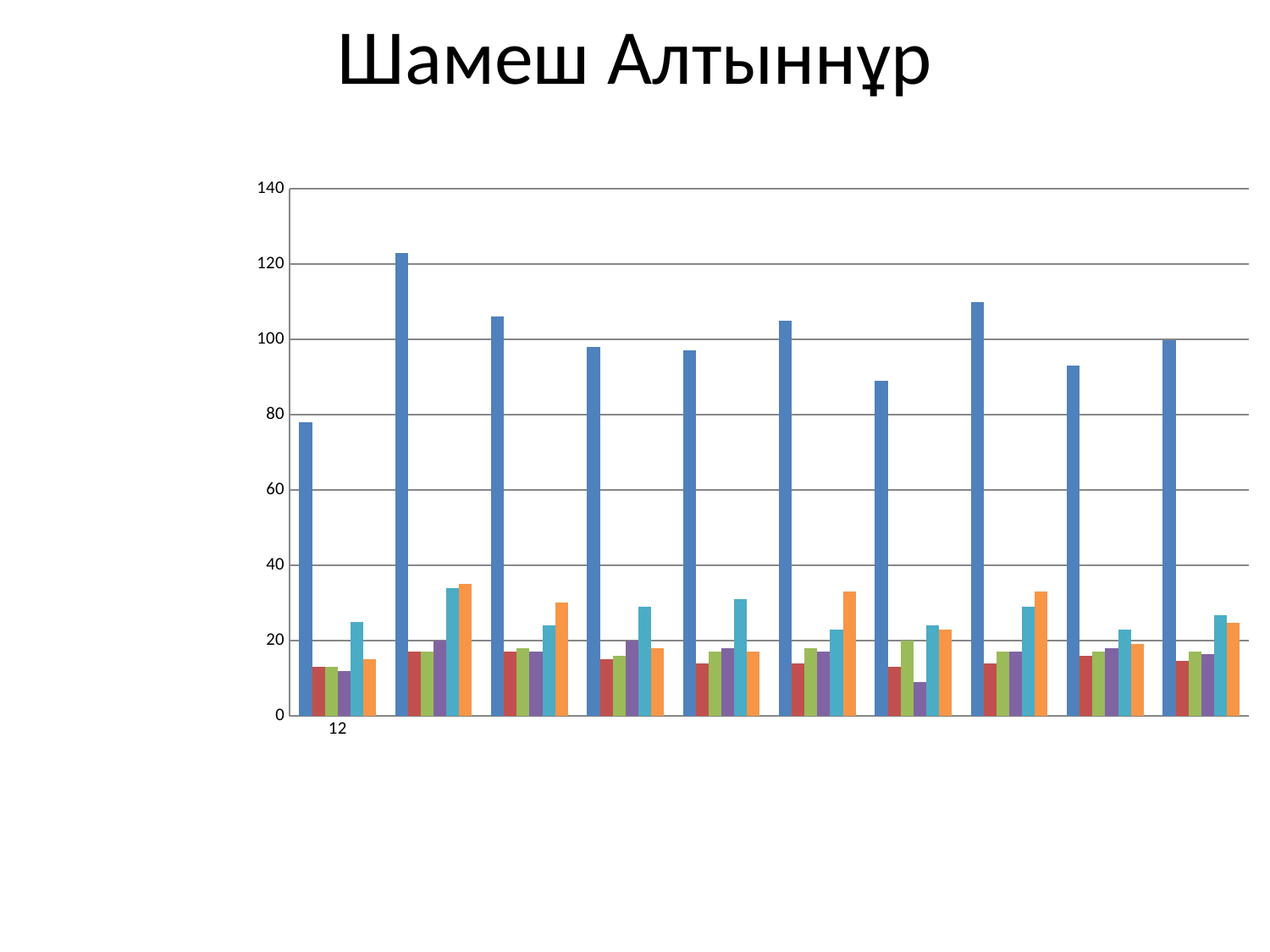
What colour are the tallest bars in every group? blue Is the blue bar in the eighth group greater or less than 100? greater What is the title shown above the chart? Шамеш Алтыннұр Is the blue bar in the first group (labelled 12) greater or less than 60? greater Is the blue bar in the seventh group greater or less than 100? less How many groups of bars are plotted along the x axis? 10 What type of chart is shown on the slide? bar chart Which group has the shortest blue bar? the first group (labelled 12) In the first group (labelled 12), which is taller: the cyan bar or the orange bar? the cyan bar How many bars are there in each group? 6 Which group has the tallest blue bar? the second group